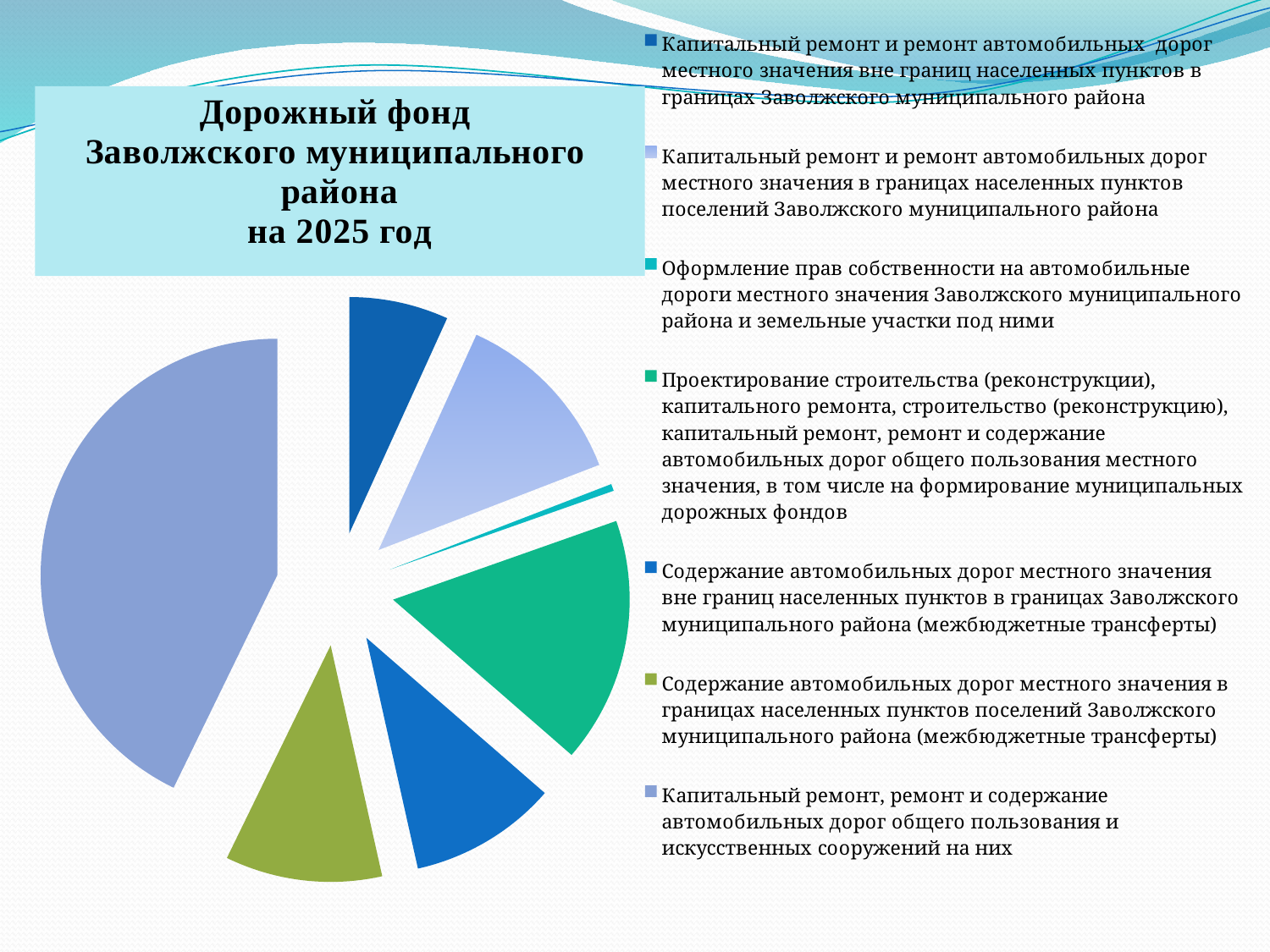
Which category has the largest slice in the pie chart? Капитальный ремонт, ремонт и содержание автомобильных дорог общего пользования и искусственных сооружений на них How many slices does the pie chart have? 7 Which slice is larger: 'Капитальный ремонт, ремонт и содержание автомобильных дорог общего пользования и искусственных сооружений на них' or 'Проектирование строительства (реконструкции)...'? Капитальный ремонт, ремонт и содержание автомобильных дорог общего пользования и искусственных сооружений на них How many entries does the legend of the pie chart list? 7 What kind of chart is shown on the slide? Pie chart Which slice is larger: 'Содержание автомобильных дорог местного значения в границах населенных пунктов поселений... (межбюджетные трансферты)' or 'Оформление прав собственности...'? Содержание автомобильных дорог местного значения в границах населенных пунктов поселений... (межбюджетные трансферты) Which category has the smallest slice in the pie chart? Оформление прав собственности на автомобильные дороги местного значения Заволжского муниципального района и земельные участки под ними Which year does the chart title refer to? 2025 What is the title of the chart on the slide? Дорожный фонд Заволжского муниципального района на 2025 год Which slice is larger: the one for 'Проектирование строительства (реконструкции)...' or the one for 'Оформление прав собственности...'? Проектирование строительства (реконструкции)...